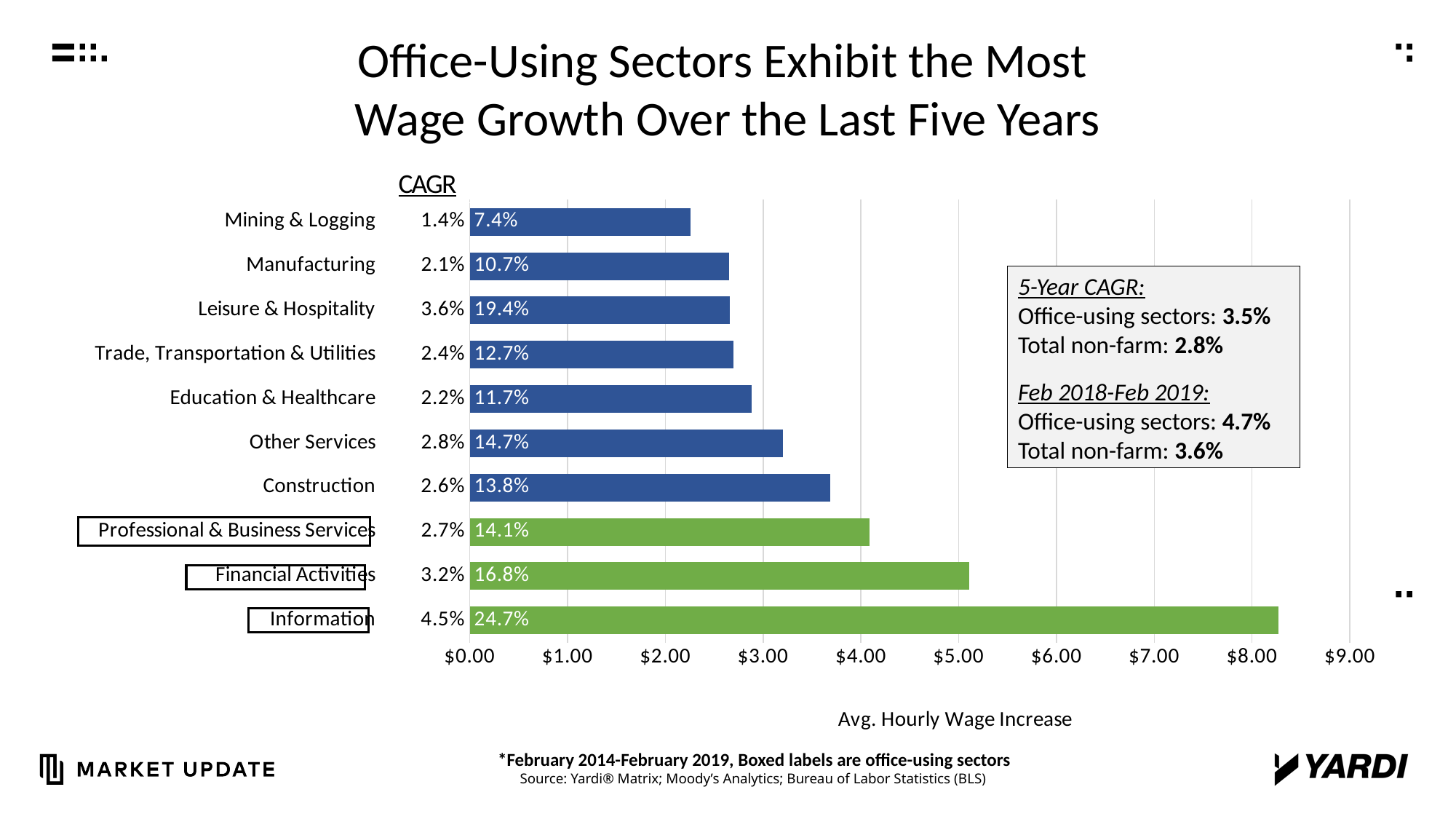
What percentage label is shown on the bar for Leisure & Hospitality? 19.4% What does the x axis of the chart measure? Avg. Hourly Wage Increase Which sector has the longest bar for average hourly wage increase? Information Which has a larger average hourly wage increase, Construction or Education & Healthcare? Construction What is the difference between the percentage labels for Information (24.7%) and Mining & Logging (7.4%)? 17.3% What kind of chart is shown on the slide? bar chart What is the CAGR value listed for Financial Activities? 3.2% Which sector has the shortest bar for average hourly wage increase? Mining & Logging How many sectors are plotted in the chart? 10 What percentage label is shown on the bar for Information? 24.7% Is the average hourly wage increase for Information greater or less than $8.00? greater